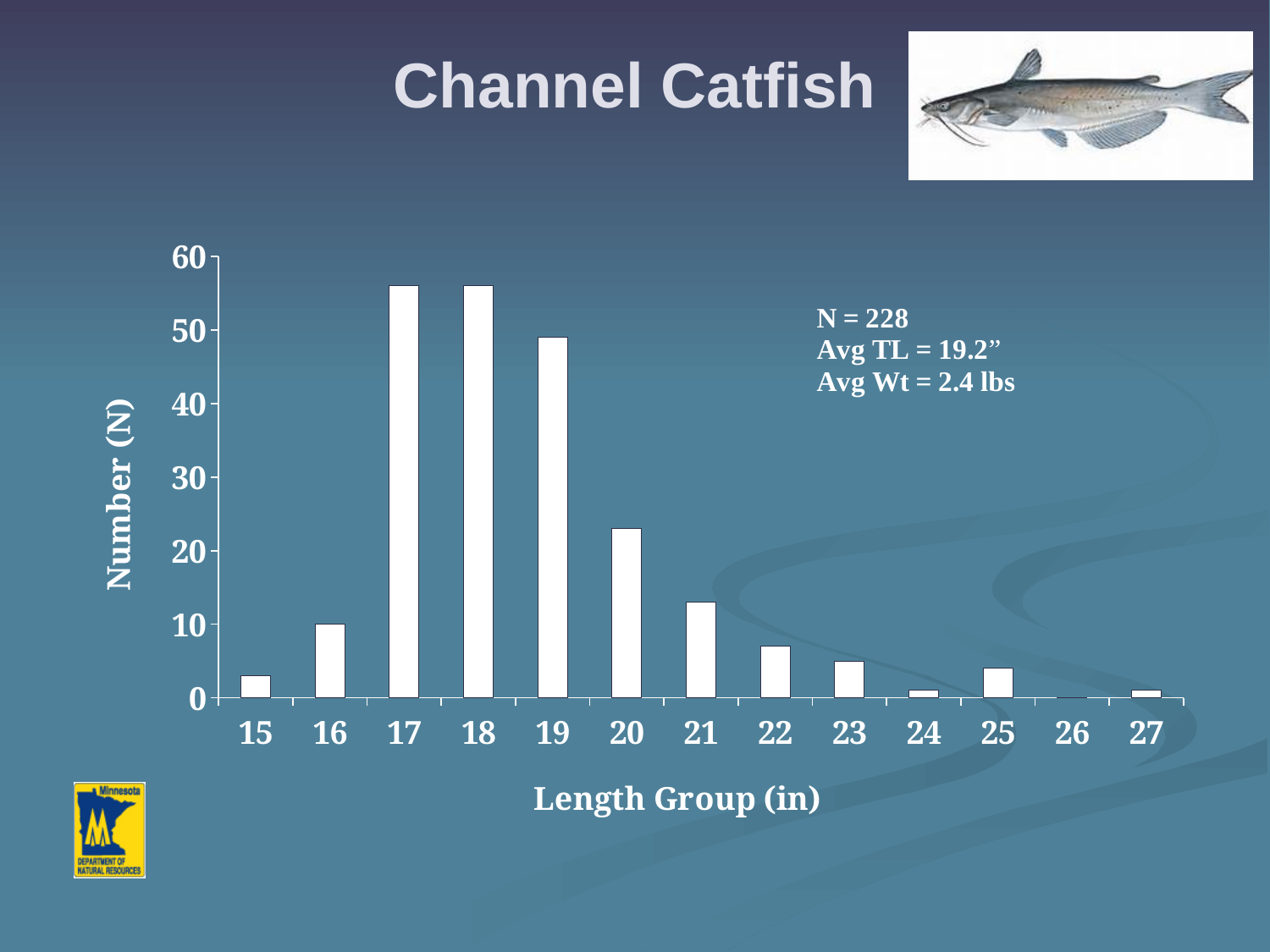
Is the value for length group 21 greater or less than 10? greater How many length groups are shown on the x axis? 13 Is the value for length group 17 greater or less than 50? greater What is the label of the x axis? Length Group (in) What kind of chart is shown on the slide? bar chart Do the values rise or fall from length group 19 to length group 24? fall Which has a larger value, length group 22 or length group 25? 22 Which length group has the lowest number of fish? 26 Is the value for length group 15 greater or less than 10? less Which has a larger value, length group 19 or length group 20? 19